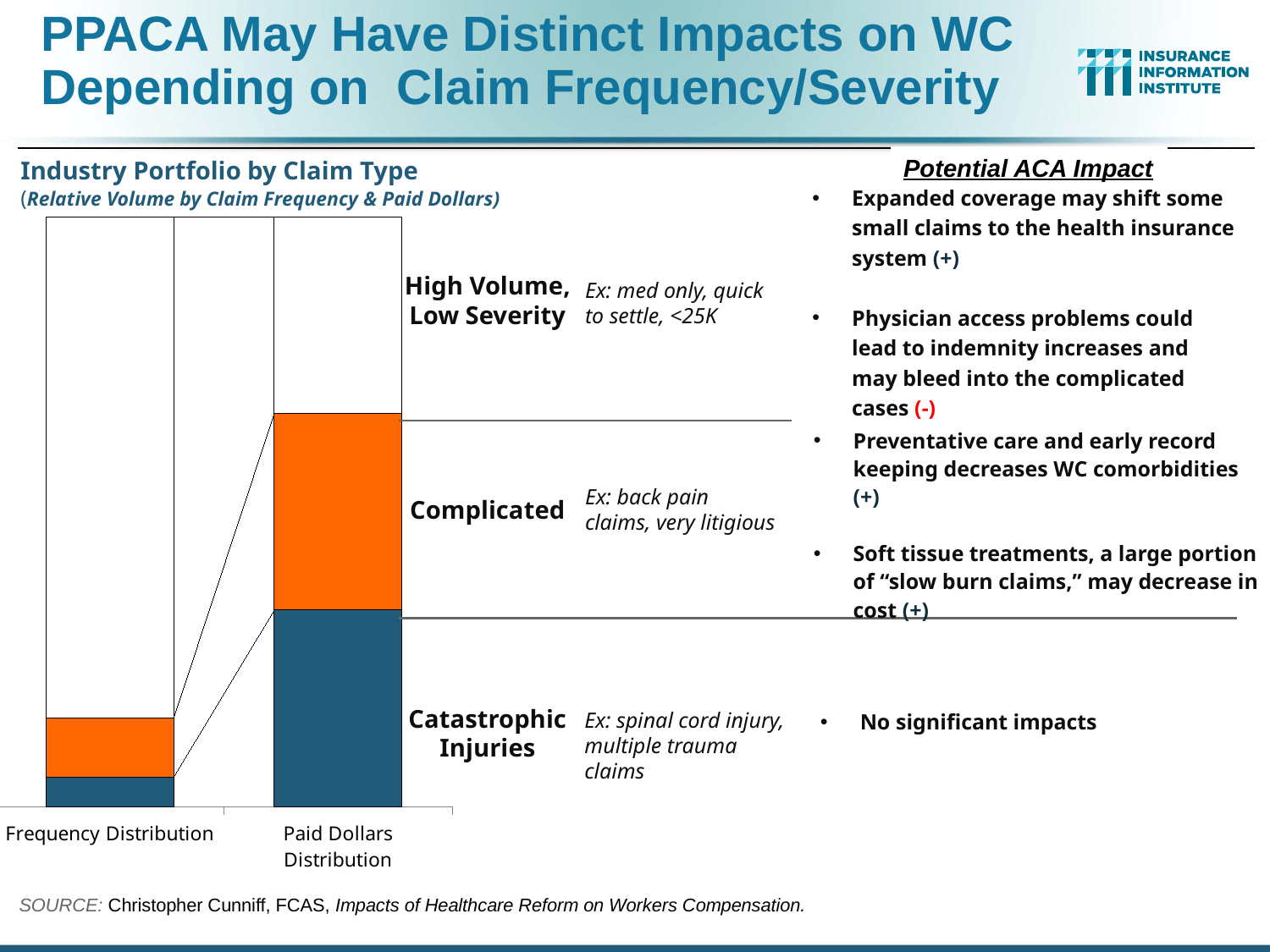
In the Frequency Distribution bar, which claim type takes up the smallest share? Catastrophic Injuries Is the Complicated segment larger in the Frequency Distribution bar or in the Paid Dollars Distribution bar? Paid Dollars Distribution What kind of chart is shown on the slide? Stacked bar chart Which claim type is shown in orange in the chart? Complicated What is the title of the chart? Industry Portfolio by Claim Type Is the High Volume, Low Severity segment larger in the Frequency Distribution bar or in the Paid Dollars Distribution bar? Frequency Distribution Is the Catastrophic Injuries segment larger in the Frequency Distribution bar or in the Paid Dollars Distribution bar? Paid Dollars Distribution How many claim-type segments make up each stacked bar? 3 How many bars does the chart show? 2 In the Frequency Distribution bar, which claim type takes up the largest share? High Volume, Low Severity What are the two categories on the x axis of the chart? Frequency Distribution and Paid Dollars Distribution